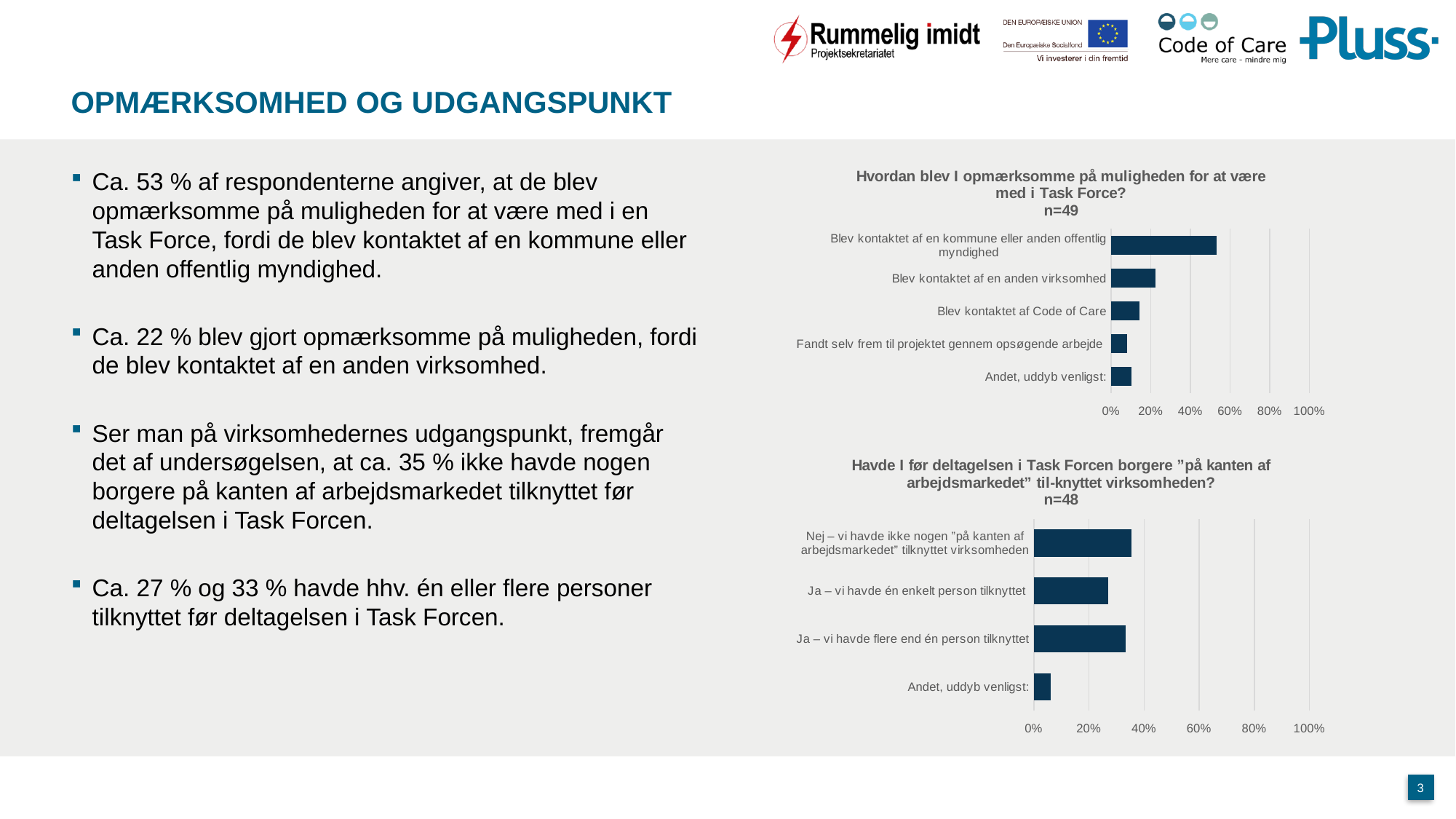
In the bottom chart, is the value for "Andet, uddyb venligst:" greater or less than 20%? less What is the sample size (n) stated in the title of the top chart? n=49 In the top chart ("Hvordan blev I opmærksomme på muligheden for at være med i Task Force?"), which category has the highest value? Blev kontaktet af en kommune eller anden offentlig myndighed In the bottom chart, is the value for "Nej – vi havde ikke nogen "på kanten af arbejdsmarkedet" tilknyttet virksomheden" greater or less than 40%? less How many categories are shown in the bottom chart? 4 In the top chart, which is larger: "Blev kontaktet af Code of Care" or "Fandt selv frem til projektet gennem opsøgende arbejde"? Blev kontaktet af Code of Care In the top chart, is the value for "Blev kontaktet af en anden virksomhed" greater or less than 40%? less What is the sample size (n) stated in the title of the bottom chart? n=48 What type of chart is the bottom chart ("Havde I før deltagelsen i Task Forcen borgere ...")? bar chart In the bottom chart, which category has the lowest value? Andet, uddyb venligst: How many categories are shown in the top chart? 5